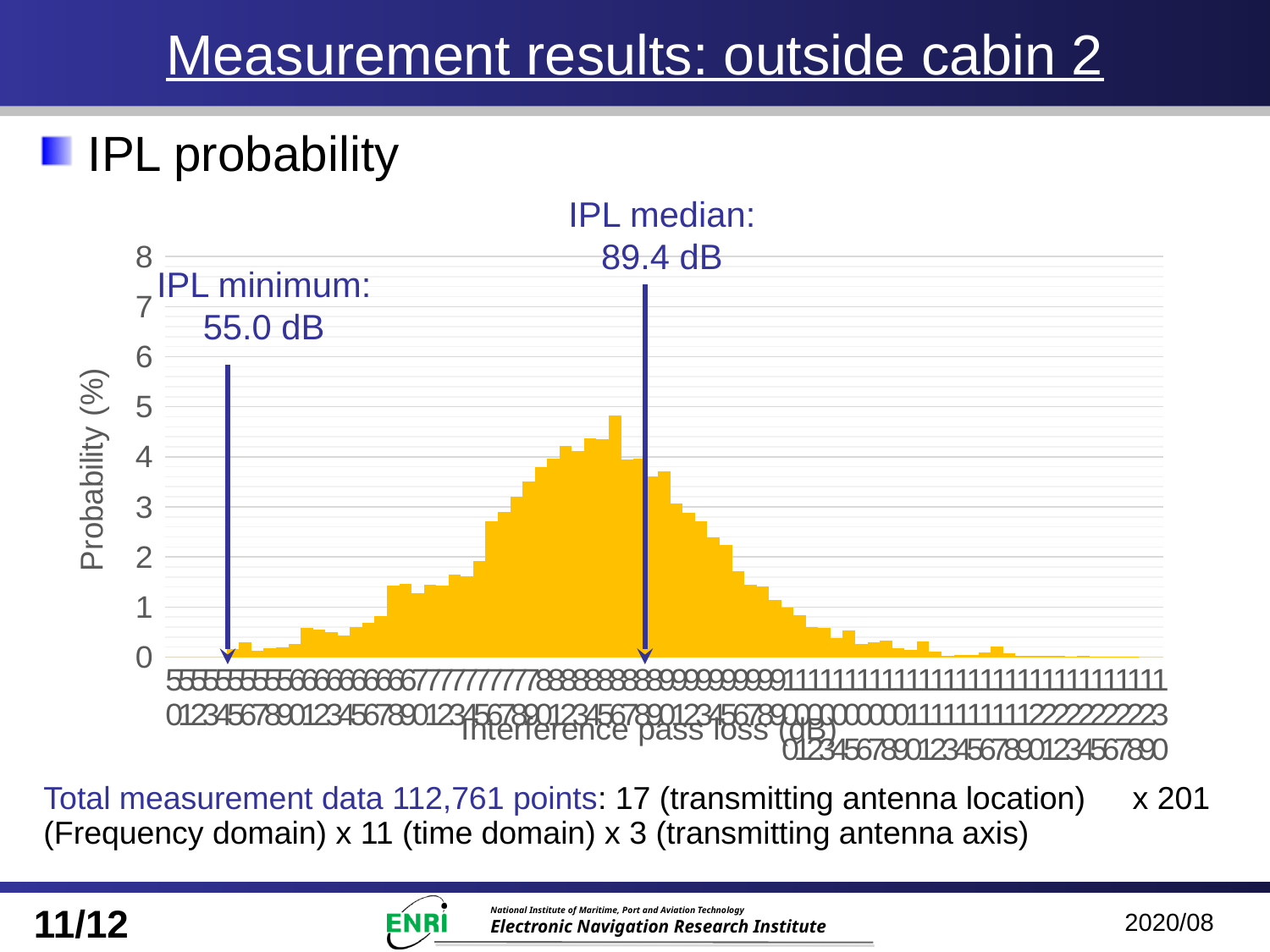
What is the label of the vertical axis of the chart? Probability (%) What is the IPL minimum value annotated on the chart? 55.0 dB Do the bar values rise or fall moving from the IPL minimum line toward the IPL median line? rise Is the tallest bar in the chart greater or less than 4? greater What is the IPL median value annotated on the chart? 89.4 dB What is the highest tick value shown on the vertical axis? 8 Which is larger: the IPL median or the IPL minimum? IPL median Is the tallest bar in the chart greater or less than 5? less What is the label of the horizontal axis of the chart? Interference pass loss (dB) Do the bar values rise or fall moving to the right of the IPL median line? fall Is the bar at the IPL minimum (55.0 dB) greater or less than 1? less What kind of chart is shown on the slide? bar chart